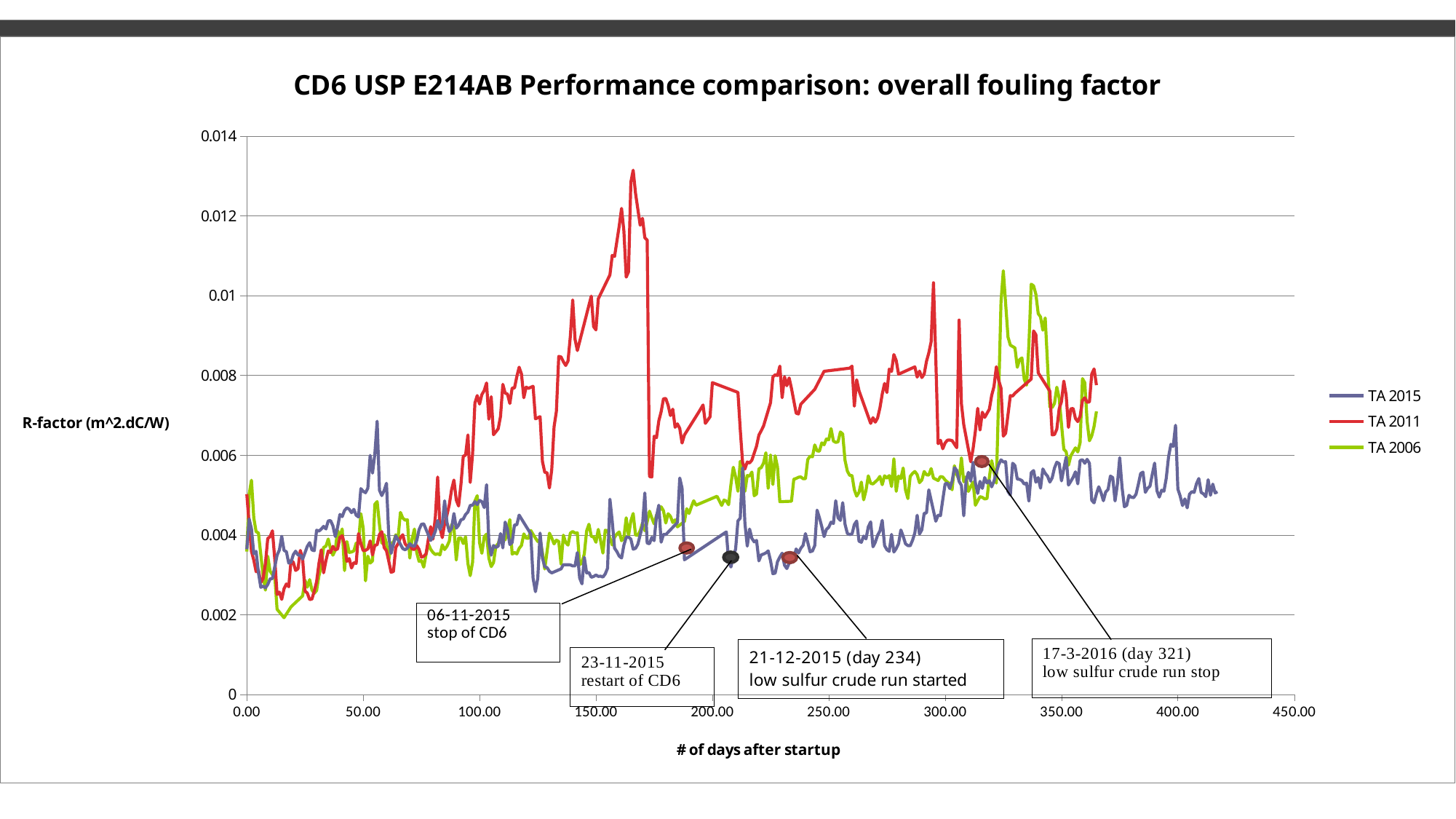
Is the peak value of the TA 2011 series greater or less than 0.012? greater What is the label of the x axis? # of days after startup Is the peak value of the TA 2006 series greater or less than 0.012? less On which day after startup did the low sulfur crude run start, according to the annotation? day 234 Which series extends furthest along the x axis (to the most days after startup)? TA 2015 Is the peak value of the TA 2015 series greater or less than 0.008? less What is the title of the chart? CD6 USP E214AB Performance comparison: overall fouling factor Which series reaches the highest R-factor value on the chart? TA 2011 How many series does the legend list? 3 Does the TA 2011 series generally rise or fall between day 0 and day 150? rise Which series has the higher peak value, TA 2011 or TA 2015? TA 2011 What kind of chart is shown on the slide? line chart